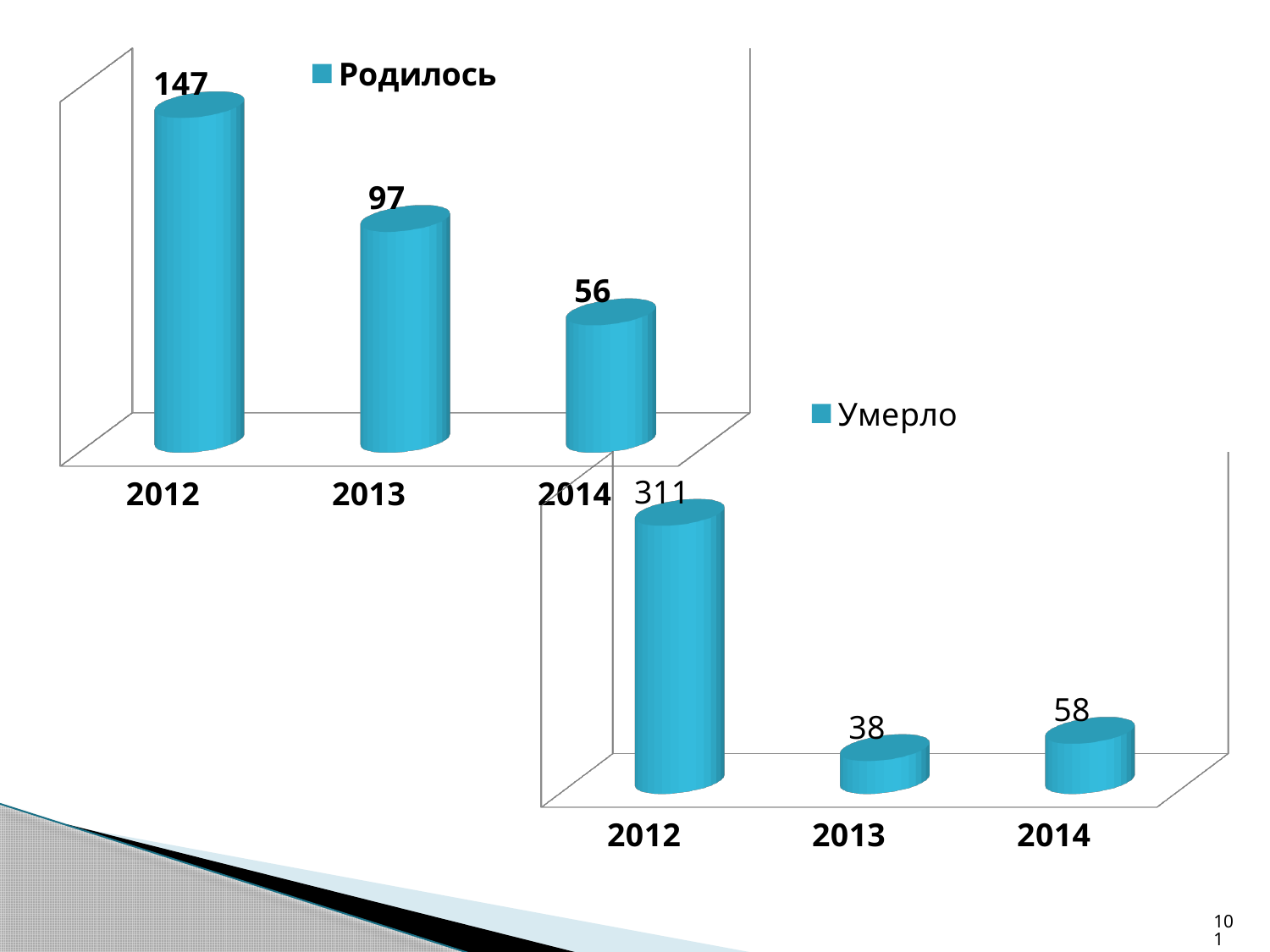
In the 'Умерло' chart (bottom right), what is the value for 2012? 311 In the 'Родилось' chart (top left), what is the difference between the values for 2012 and 2013? 50 In the 'Умерло' chart (bottom right), which is larger, the value for 2013 or the value for 2014? 2014 In the 'Умерло' chart (bottom right), what is the difference between the values for 2014 and 2013? 20 In the 'Родилось' chart (top left), what is the value for 2012? 147 In the 'Родилось' chart (top left), do the values rise or fall from 2012 to 2014? fall How many years are shown in the 'Родилось' chart (top left)? 3 In the 'Умерло' chart (bottom right), which year has the lowest value? 2013 In the 'Родилось' chart (top left), which year has the highest value? 2012 In the 'Родилось' chart (top left), what is the value for 2014? 56 What kind of chart is the 'Умерло' chart (bottom right)? bar chart In the 'Умерло' chart (bottom right), what is the value for 2013? 38